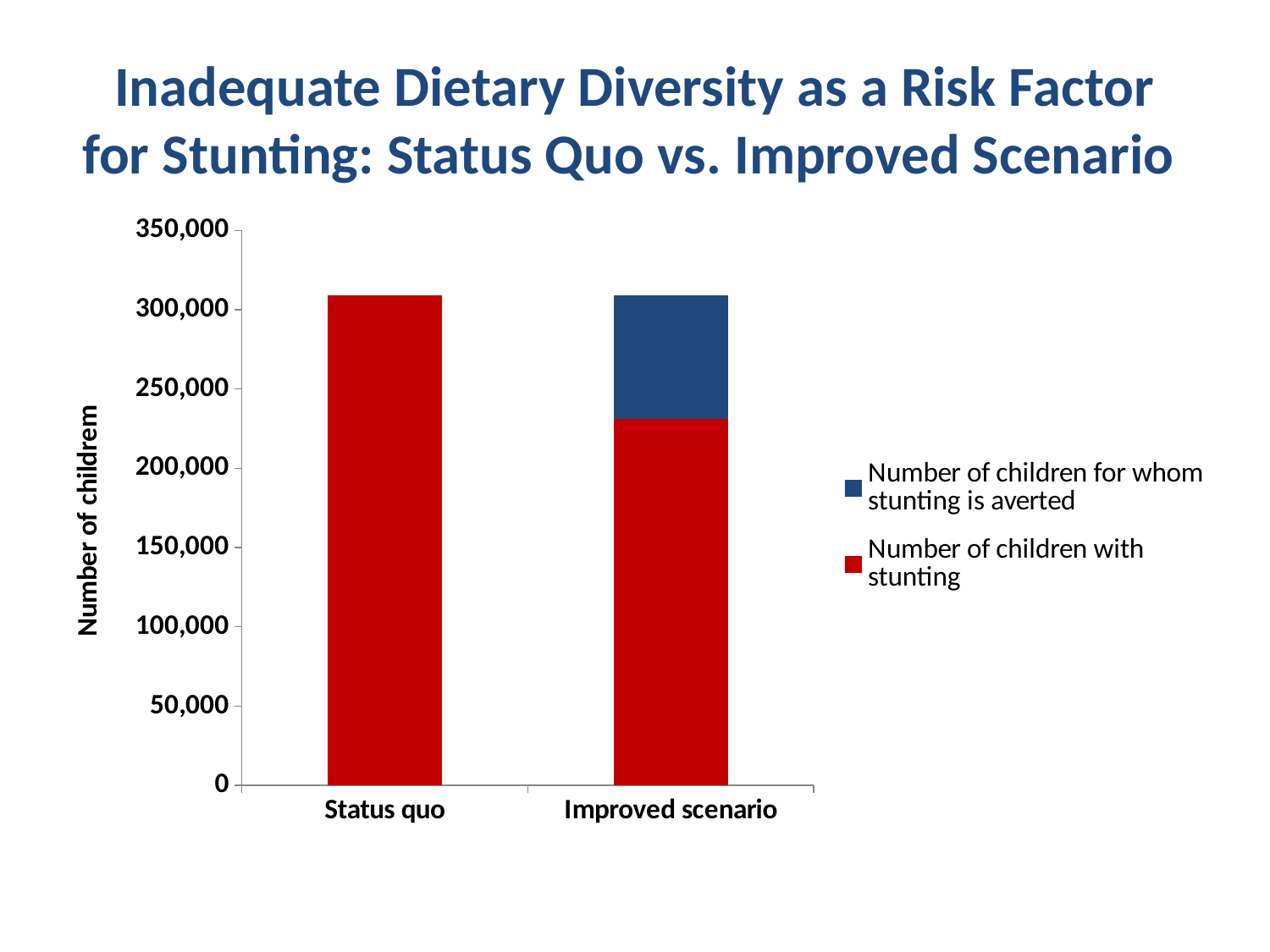
Is the number of children for whom stunting is averted in the Improved scenario greater or less than 100,000? less Is the number of children with stunting for Improved scenario greater or less than 200,000? greater What kind of chart is shown on the slide? Stacked bar chart How many categories are shown on the x axis? 2 How many series does the legend list? 2 In the Improved scenario bar, which segment is larger: children with stunting or children for whom stunting is averted? Number of children with stunting Which category has the lower number of children with stunting? Improved scenario Is the number of children with stunting for Improved scenario greater or less than 250,000? less Which colour represents the number of children for whom stunting is averted? Blue What is the label of the y axis? Number of childrem Which category has the higher number of children with stunting? Status quo